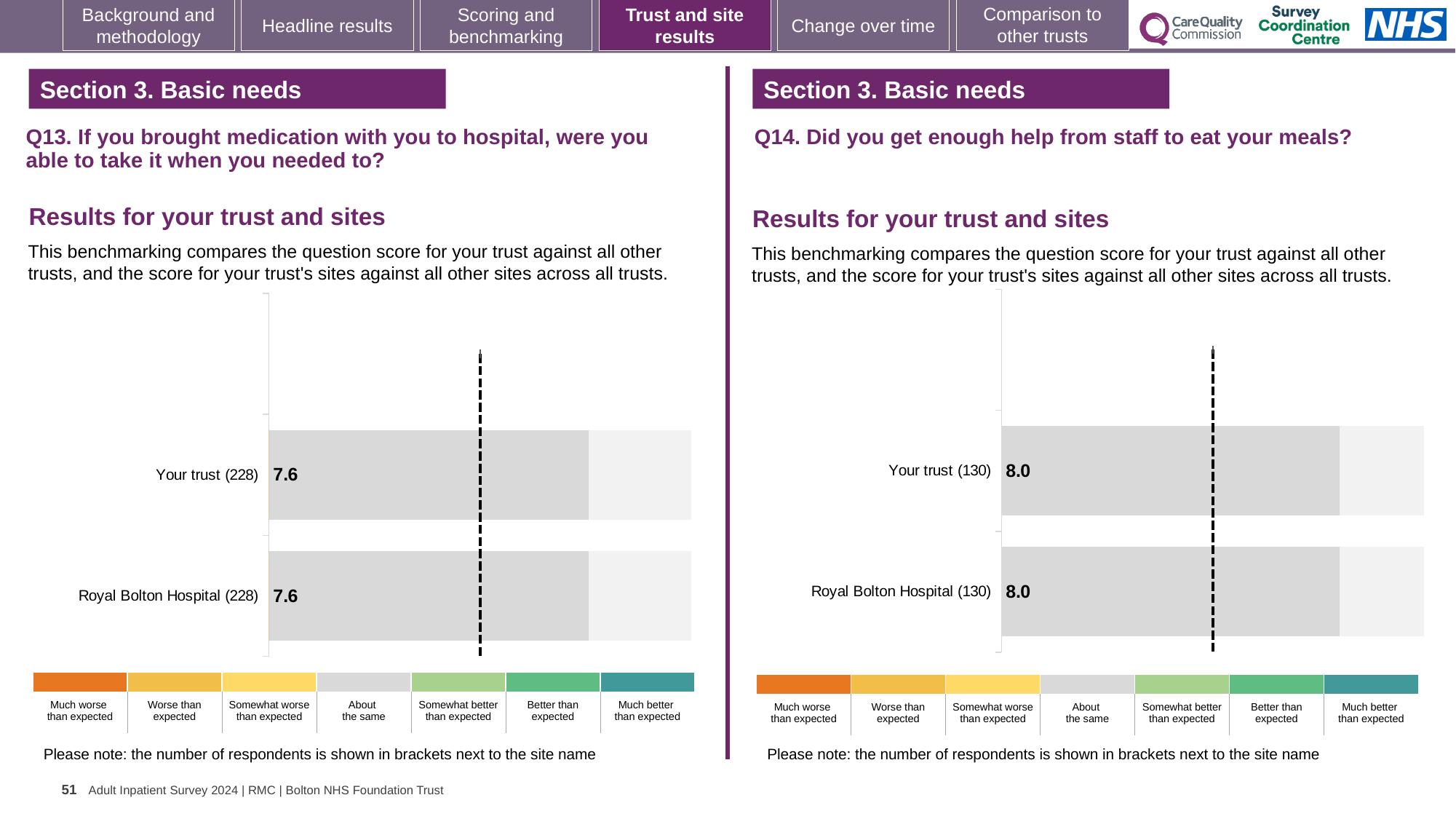
How many bars are plotted on the Q13 chart (left)? 2 Is the score for Your trust on the Q14 chart (right) larger than the score for Your trust on the Q13 chart (left)? Yes On the Q14 chart (right), what is the score for Your trust? 8.0 On the Q14 chart (right), what is the difference between the score for Your trust and the score for Royal Bolton Hospital? 0.0 What type of chart is used on the Q13 chart (left)? Bar chart On the Q13 chart (left), what is the score for Your trust? 7.6 On the Q13 chart (left), how many respondents are shown in brackets for Your trust? 228 On the Q13 chart (left), what is the difference between the score for Your trust and the score for Royal Bolton Hospital? 0.0 On the Q13 chart (left), what is the score for Royal Bolton Hospital? 7.6 How many bars are plotted on the Q14 chart (right)? 2 On the Q14 chart (right), how many respondents are shown in brackets for Royal Bolton Hospital? 130 On the Q14 chart (right), what is the score for Royal Bolton Hospital? 8.0